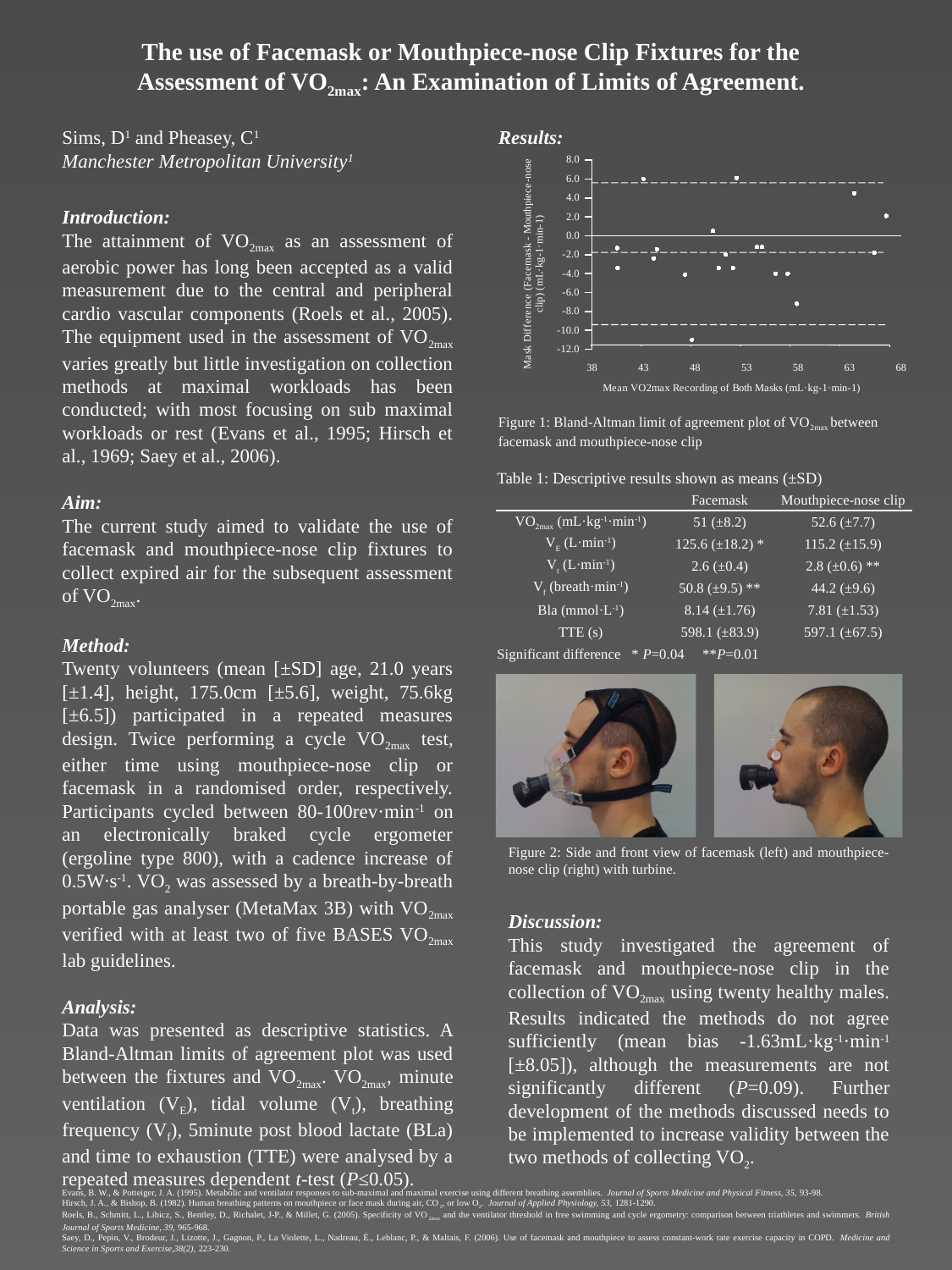
In Figure 1, is the lowest plotted point greater or less than -10.0? less In Figure 1, is the rightmost plotted point (near x = 66) greater or less than 0.0? greater In Figure 1, what is the highest tick value shown on the y axis? 8.0 In Figure 1, is the highest plotted point greater or less than 4.0? greater What kind of chart is shown in Figure 1? scatter plot In Figure 1, what is the title of the x axis? Mean VO2max Recording of Both Masks (mL·kg-1·min-1)